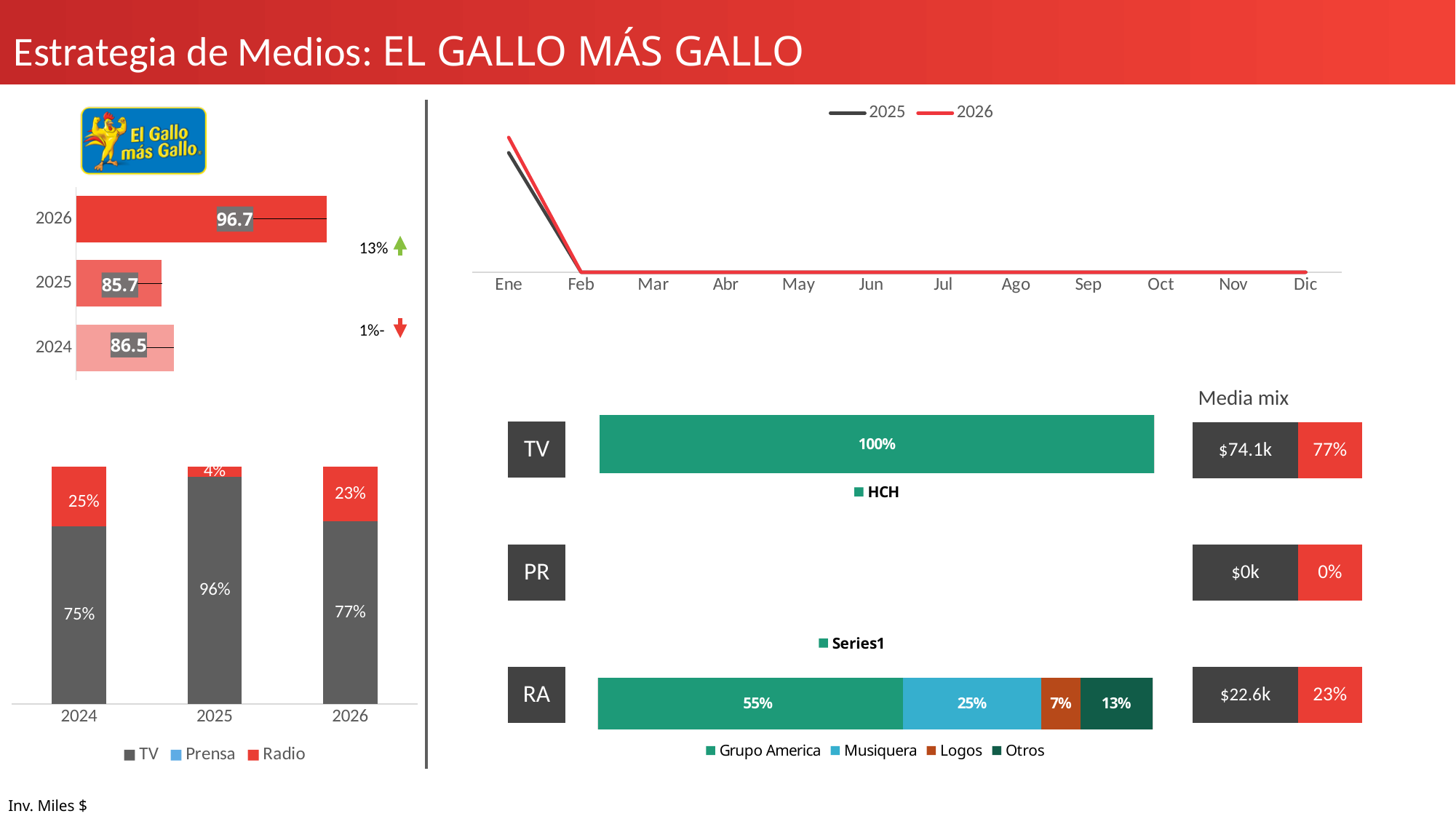
In the bottom-left stacked bar chart, what is the Radio share for 2026? 23% In the top-left horizontal bar chart, which year has the highest value? 2026 In the top-right line chart, how many series does the legend list? 2 In the top-left horizontal bar chart, what is the value for 2024? 86.5 In the bottom-right RA bar, which station has the largest share? Grupo America In the top-left horizontal bar chart, what is the difference between the 2026 and 2025 values? 11 In the top-left horizontal bar chart, which year has the lowest value? 2025 In the bottom-left stacked bar chart, how many series does the legend list? 3 In the top-left horizontal bar chart, what is the value for 2026? 96.7 In the bottom-right RA bar, what is the share for Musiquera? 25% In the bottom-left stacked bar chart, which year has the larger Radio share, 2024 or 2025? 2024 In the bottom-left stacked bar chart, what is the TV share for 2025? 96%